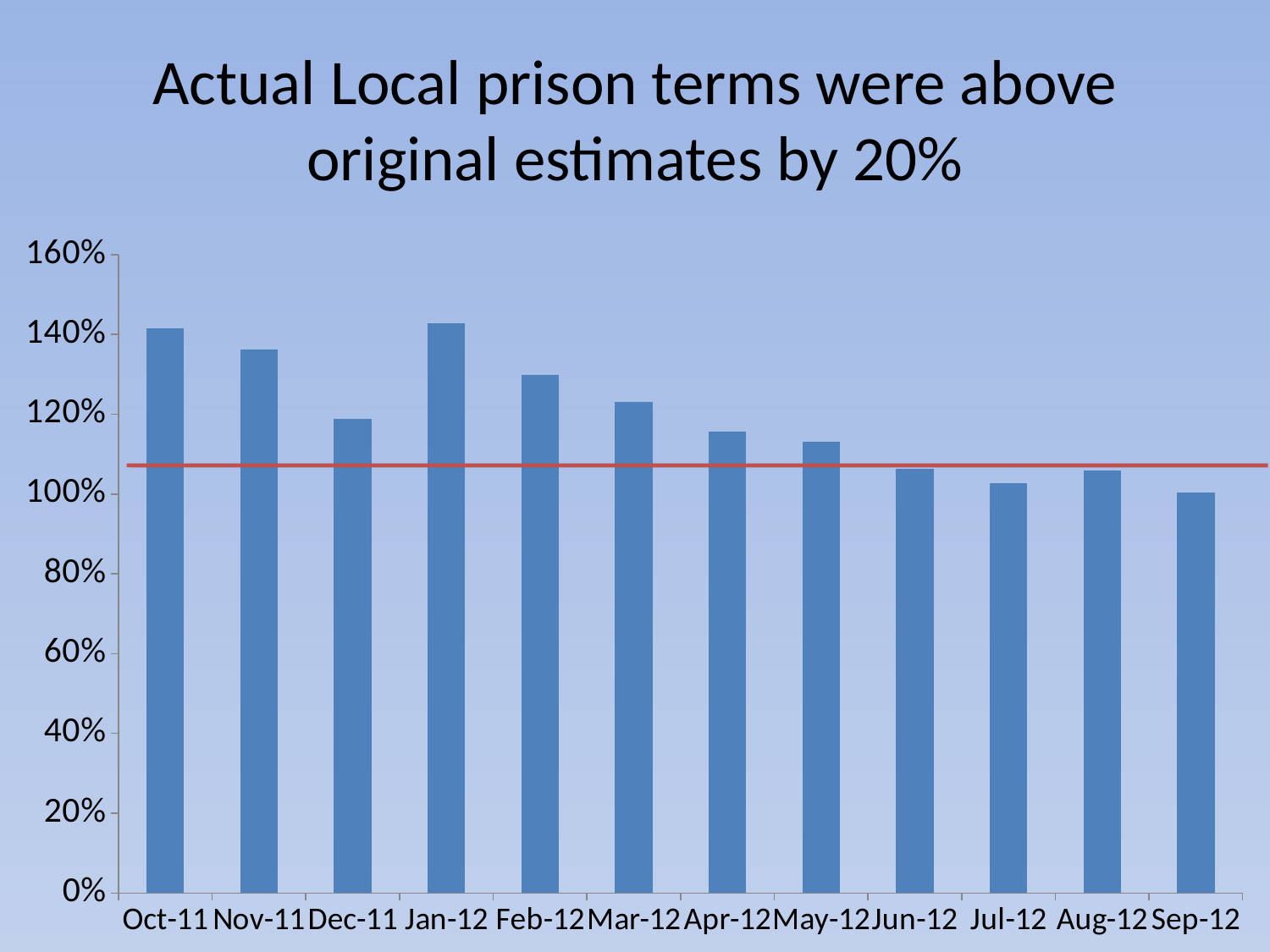
What is the title of the chart on the slide? Actual Local prison terms were above original estimates by 20% Which is larger, the value for Oct-11 or the value for Dec-11? Oct-11 What kind of chart is shown on the slide? bar chart Which is larger, the value for Nov-11 or the value for Sep-12? Nov-11 Is the value for Feb-12 greater or less than 120%? greater Is the value for Apr-12 greater or less than 140%? less Is the value for Oct-11 greater or less than 120%? greater Do the values generally rise or fall from Oct-11 to Sep-12? fall What colour is the horizontal reference line drawn across the chart? red How many months are shown on the x axis of the chart? 12